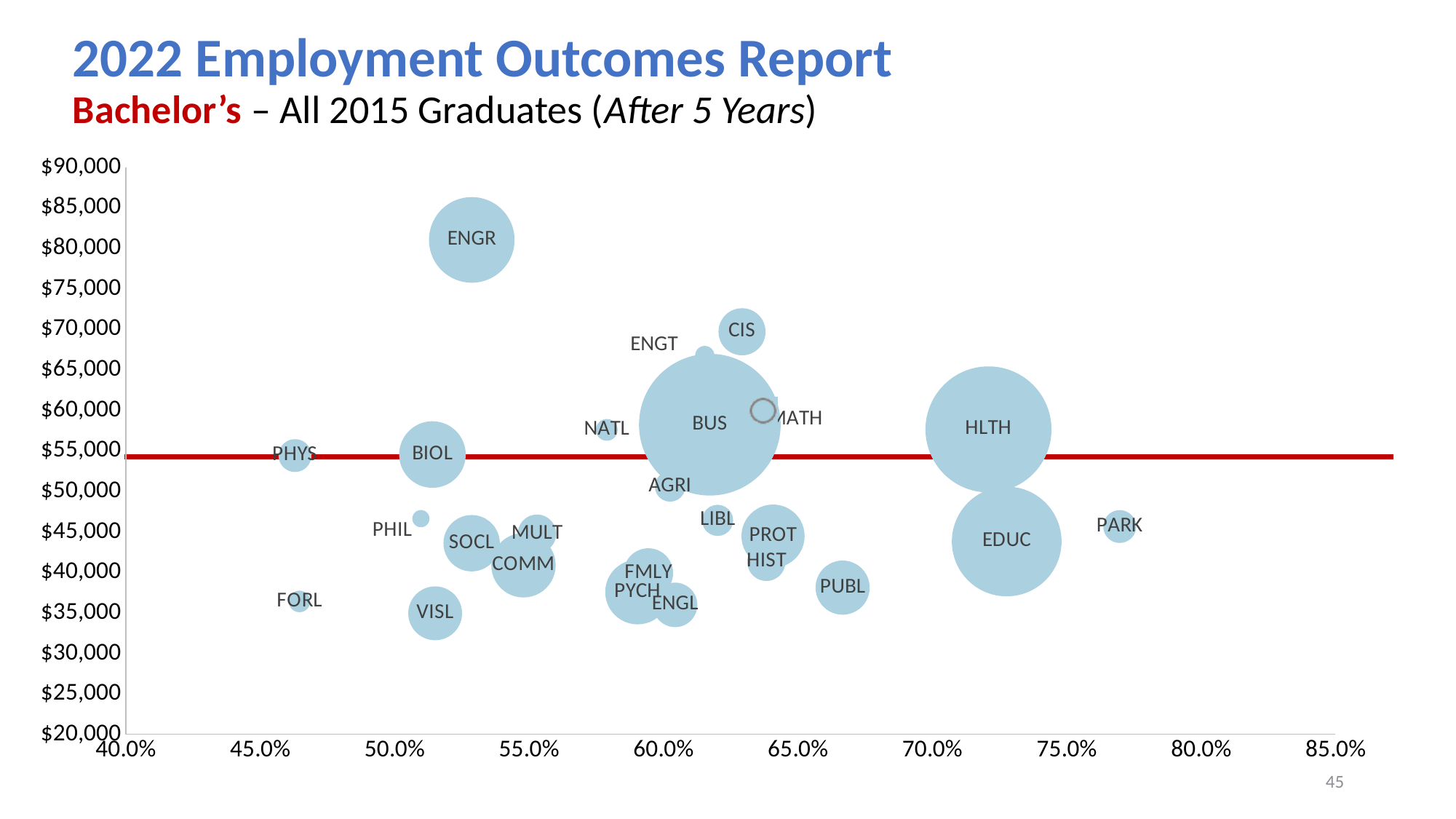
Which program has the highest value on the vertical (salary) axis? ENGR Which program has a higher salary value, ENGR or CIS? ENGR Is the horizontal-axis value for ENGR greater or less than 55.0%? less Is the salary value for CIS greater or less than $65,000? greater Which program has a higher salary value, HLTH or EDUC? HLTH Is the salary value for ENGR greater or less than $75,000? greater What kind of chart is shown on the slide? bubble chart Which program is positioned furthest to the right on the horizontal (percentage) axis? PARK What colour is the horizontal reference line drawn across the chart? red